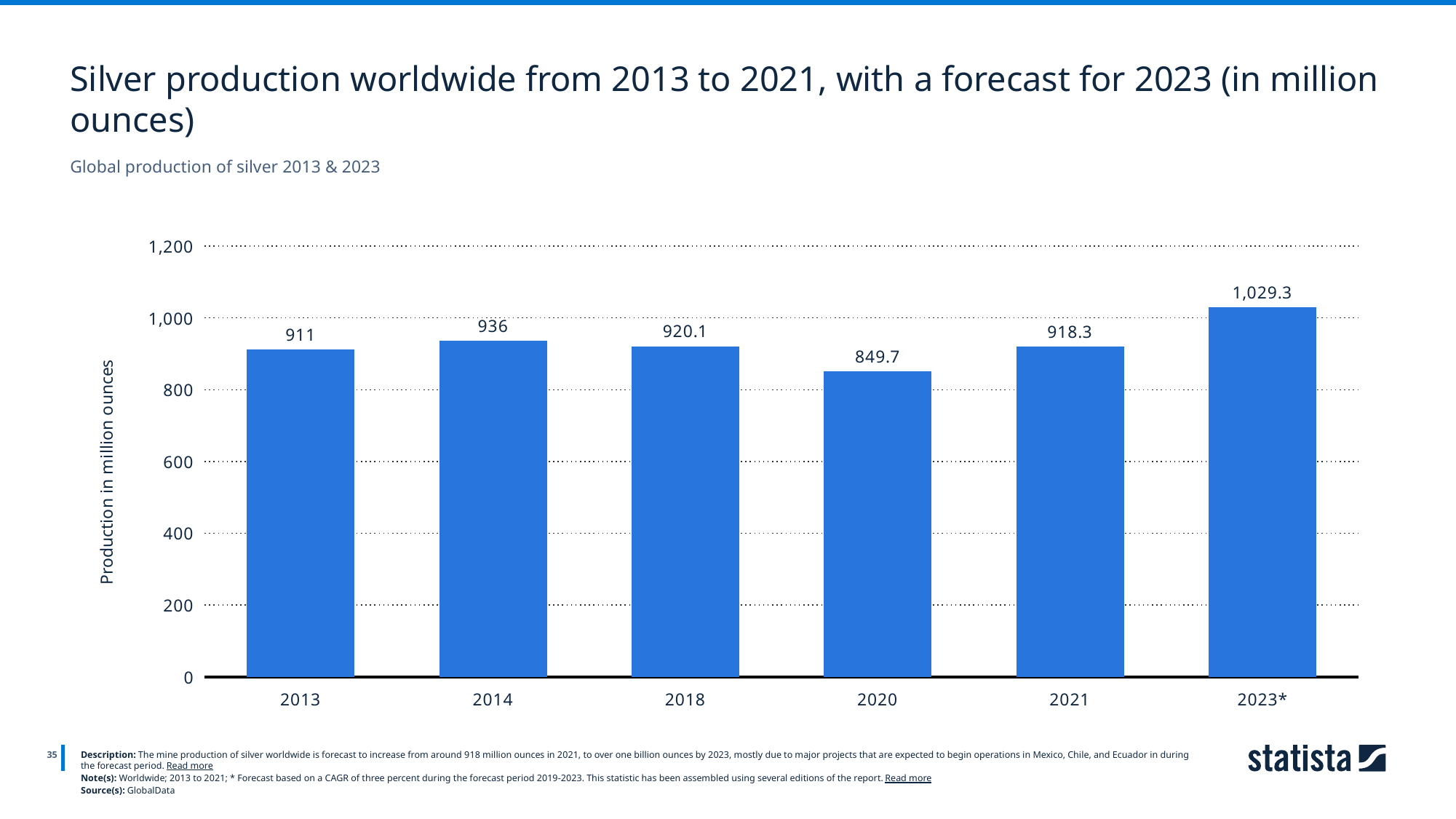
What kind of chart is shown on the slide? Bar chart What is the forecast silver production for 2023*? 1,029.3 What is the label of the y axis? Production in million ounces Which year has the lowest silver production value on the chart? 2020 Which year has the highest silver production value on the chart? 2023* How many years are shown on the x axis of the chart? 6 What is the difference between the silver production in 2014 and in 2013? 25 Is the value for 2020 greater or less than 1,000? less Which year had higher silver production, 2014 or 2018? 2014 What is the difference between the silver production in 2021 and in 2020? 68.6 What was the silver production worldwide in 2020? 849.7 What was the silver production worldwide in 2013? 911